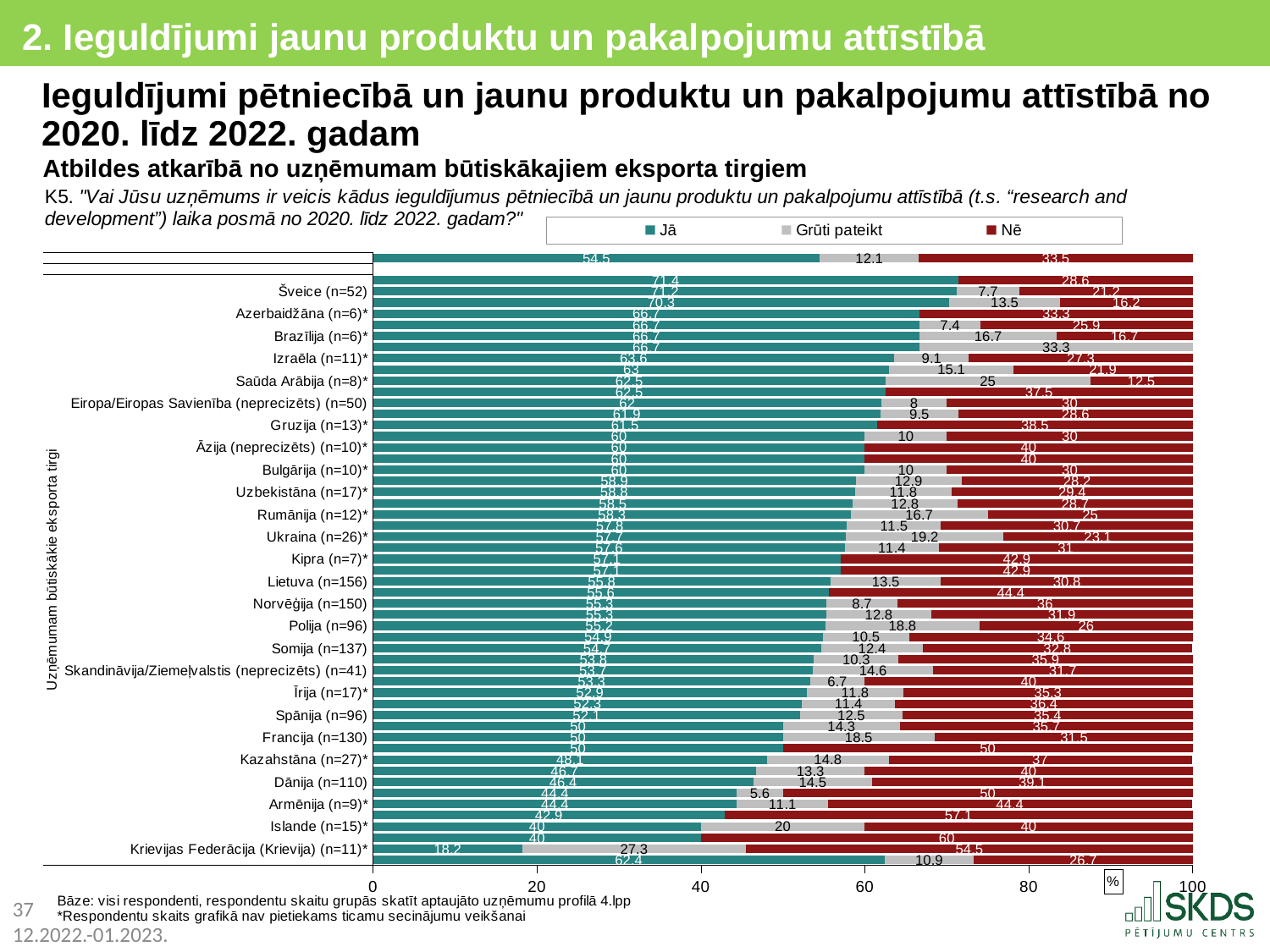
What is the 'Nē' value for Krievijas Federācija (Krievija) (n=11)*? 54.5 What are the three legend entries of the chart? Jā, Grūti pateikt, Nē Is the 'Jā' value for Krievijas Federācija (Krievija) (n=11)* greater or less than 20? less What is the difference between the 'Nē' and 'Jā' values for Krievijas Federācija (Krievija) (n=11)*? 36.3 What is the 'Jā' value for Šveice (n=52)? 71.2 What is the 'Nē' value for Lietuva (n=156)? 30.8 What kind of chart is shown on the slide? Stacked bar chart What is the 'Jā' value for Lietuva (n=156)? 55.8 How many series does the legend list? 3 What is the 'Jā' value for Krievijas Federācija (Krievija) (n=11)*? 18.2 Which has the larger 'Jā' value: Šveice (n=52) or Krievijas Federācija (Krievija) (n=11)*? Šveice (n=52) What is the 'Jā' value shown on the topmost bar of the chart? 54.5